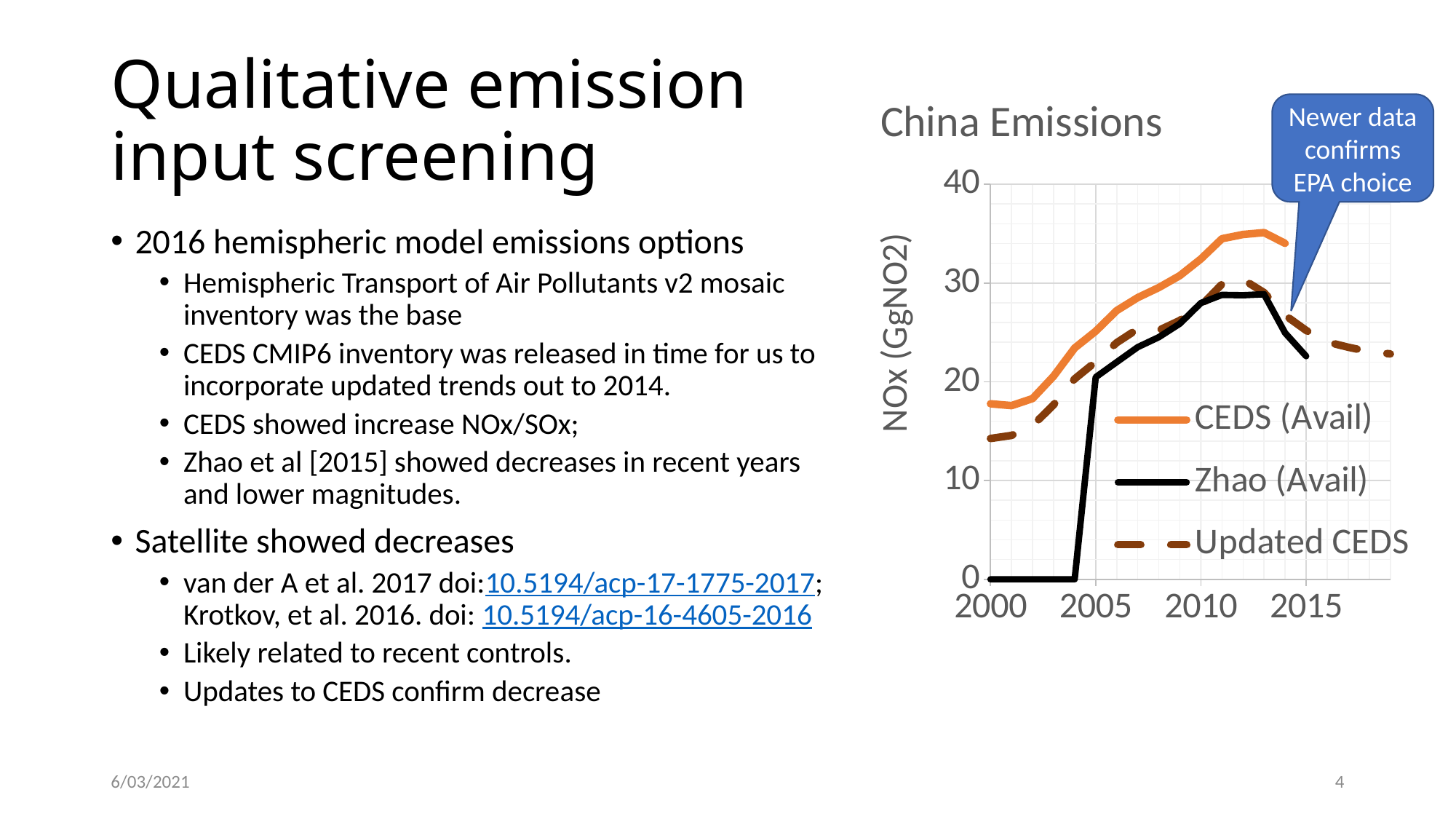
In the China Emissions chart, is the value for Updated CEDS in 2000 greater or less than 20? less What is the label on the vertical axis of the China Emissions chart? NOx (GgNO2) What kind of chart is shown on the slide? line chart In the China Emissions chart, which series has the highest value in 2010? CEDS (Avail) In the China Emissions chart, does the CEDS (Avail) series rise or fall between 2000 and 2010? rise How many series does the legend of the China Emissions chart list? 3 In the China Emissions chart, is the value for Zhao (Avail) in 2010 greater or less than 30? less In the China Emissions chart, is the value for CEDS (Avail) in 2010 greater or less than 30? greater What is the title of the chart on the slide? China Emissions